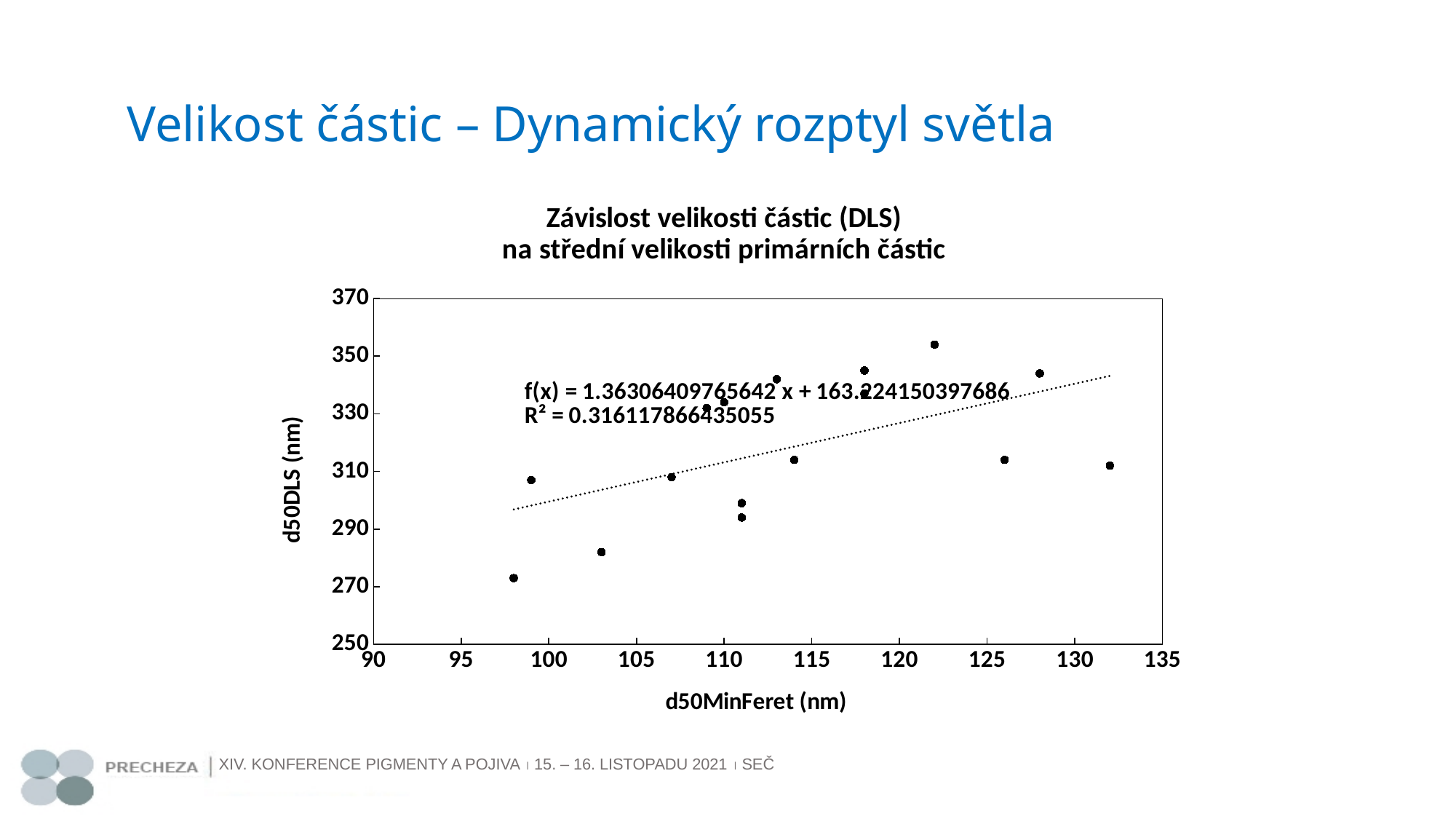
What is the title of the chart? Závislost velikosti částic (DLS) na střední velikosti primárních částic What is the label of the y axis? d50DLS (nm) Which point has the higher d50DLS value: the one at d50MinFeret 122 or the one at d50MinFeret 126? the one at 122 What R² value is printed on the chart? 0.316117866435055 Is the highest d50DLS value plotted greater or less than 350? greater Is the lowest d50DLS value plotted greater or less than 290? less What kind of chart is shown on the slide? scatter plot What is the intercept of the fitted line f(x) printed on the chart? 163.224150397686 According to the trendline, do the d50DLS values rise or fall as d50MinFeret increases? rise What is the maximum value shown on the x axis? 135 Is the d50DLS value of the point at d50MinFeret 132 greater or less than 330? less What is the slope of the fitted line f(x) printed on the chart? 1.36306409765642